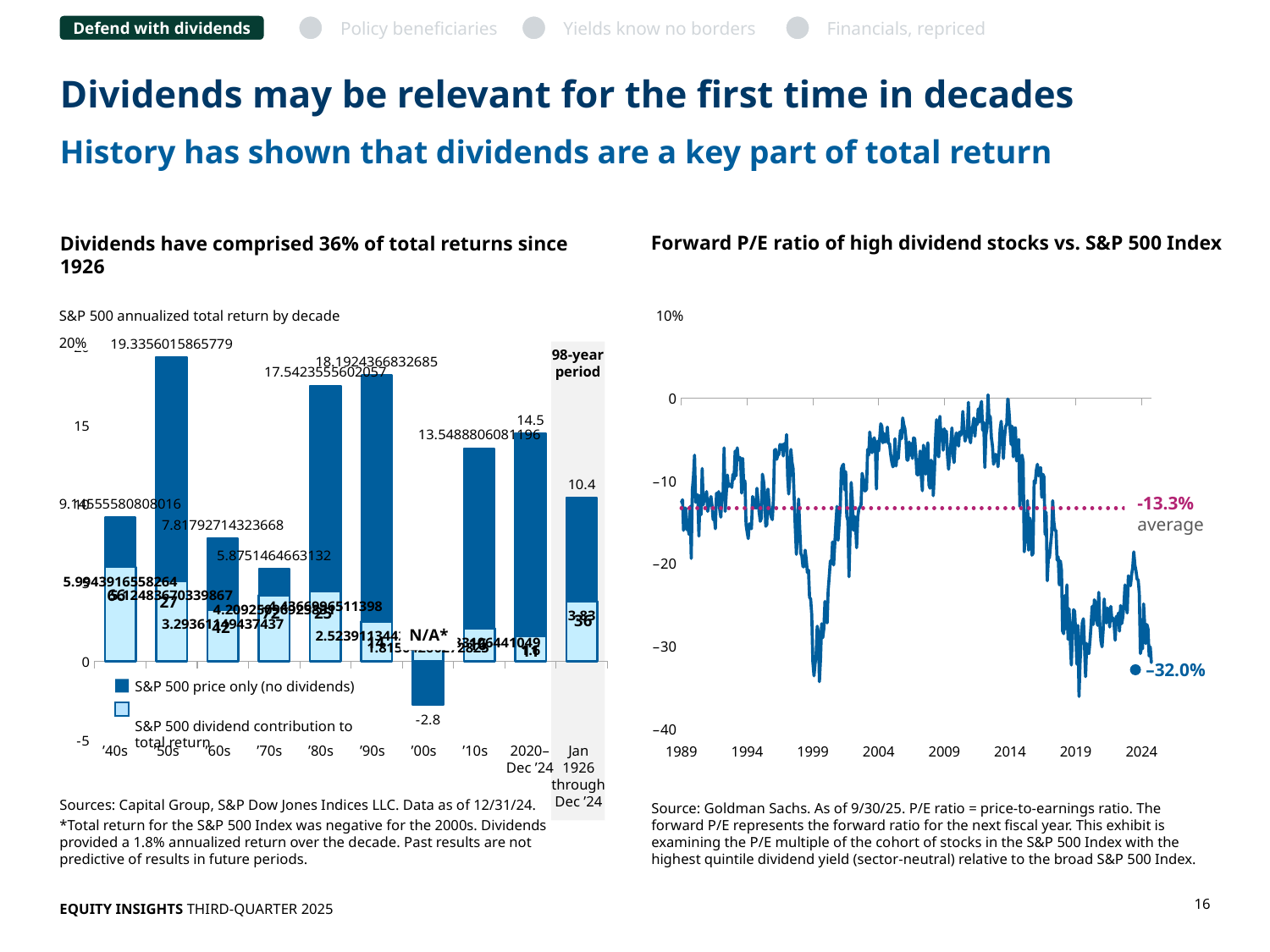
In the right chart, what is the average value marked by the dotted line? -13.3% In the left chart, what is the annualized total return shown for 2020–Dec '24? 14.5 In the left chart, which decade has the lowest annualized total return? '00s In the right chart, is the value at the end of the line in 2024 greater or less than -20? less In the right chart, what is the value labeled at the end of the line in 2024? -32.0% In the left chart, what is the value shown for the '00s? -2.8 How many series does the legend of the left chart list? 2 What kind of chart is the left chart, 'Dividends have comprised 36% of total returns since 1926'? bar chart In the left chart, is the total return for the '70s greater or less than 10? less In the left chart, which decade has the highest annualized total return? '50s In the left chart, what is the annualized total return shown for the Jan 1926 through Dec '24 period? 10.4 What kind of chart is the right chart, 'Forward P/E ratio of high dividend stocks vs. S&P 500 Index'? line chart